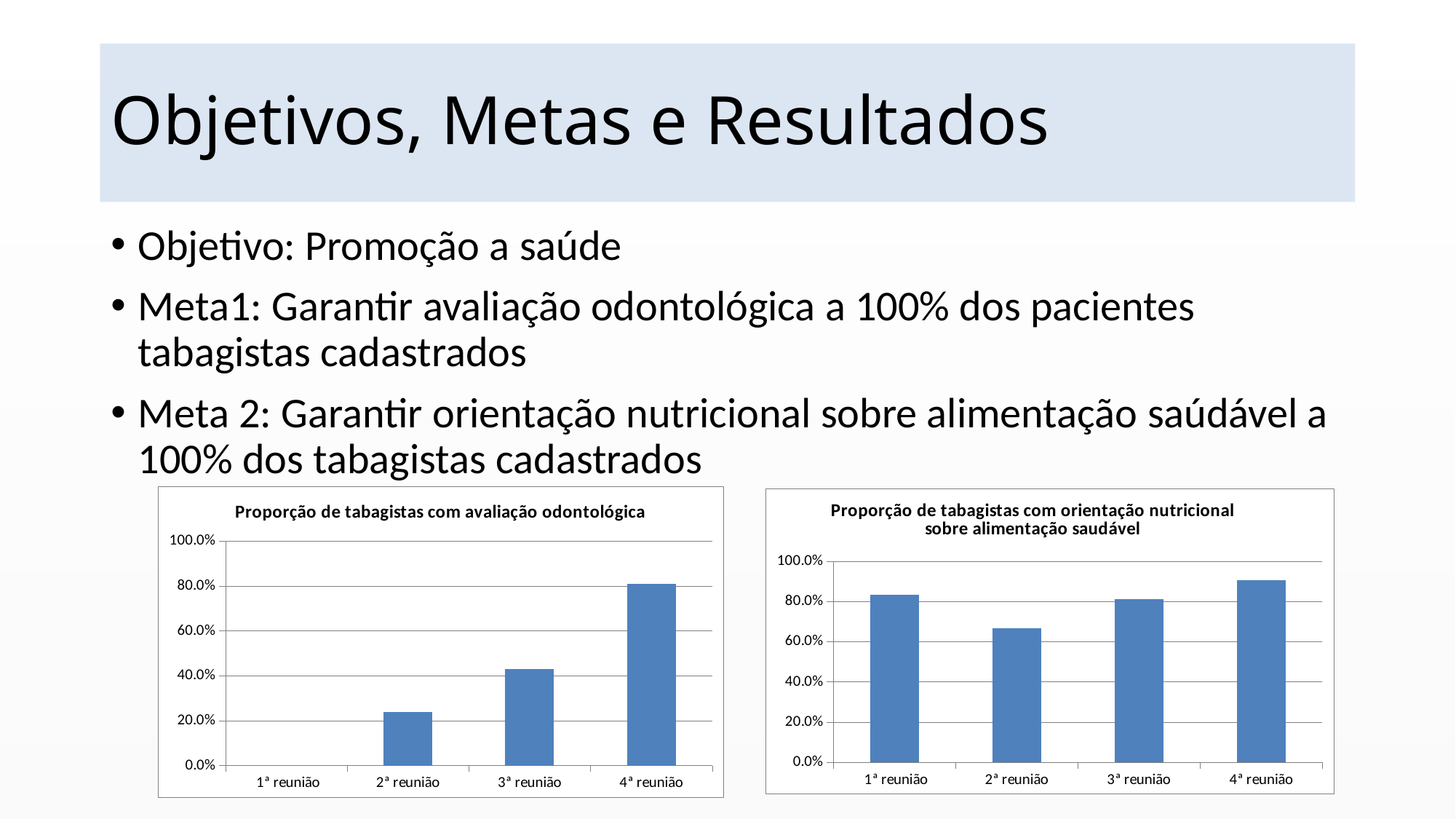
How many categories are shown on the x axis of the left chart, 'Proporção de tabagistas com avaliação odontológica'? 4 What is the title of the right chart on the slide? Proporção de tabagistas com orientação nutricional sobre alimentação saudável In the right chart, 'Proporção de tabagistas com orientação nutricional sobre alimentação saudável', is the value for 2ª reunião greater or less than 80.0%? less In the right chart, 'Proporção de tabagistas com orientação nutricional sobre alimentação saudável', which reunião has the lowest value? 2ª reunião In the left chart, 'Proporção de tabagistas com avaliação odontológica', is the value for 2ª reunião greater or less than 40.0%? less In the right chart, 'Proporção de tabagistas com orientação nutricional sobre alimentação saudável', which reunião has the highest value? 4ª reunião In the right chart, 'Proporção de tabagistas com orientação nutricional sobre alimentação saudável', which is larger: the value for 1ª reunião or the value for 2ª reunião? 1ª reunião In the left chart, 'Proporção de tabagistas com avaliação odontológica', which reunião has the lowest value? 1ª reunião In the left chart, 'Proporção de tabagistas com avaliação odontológica', do the values rise or fall from 2ª reunião to 4ª reunião? rise What kind of chart is the left chart, 'Proporção de tabagistas com avaliação odontológica'? bar chart In the left chart, 'Proporção de tabagistas com avaliação odontológica', which reunião has the highest value? 4ª reunião